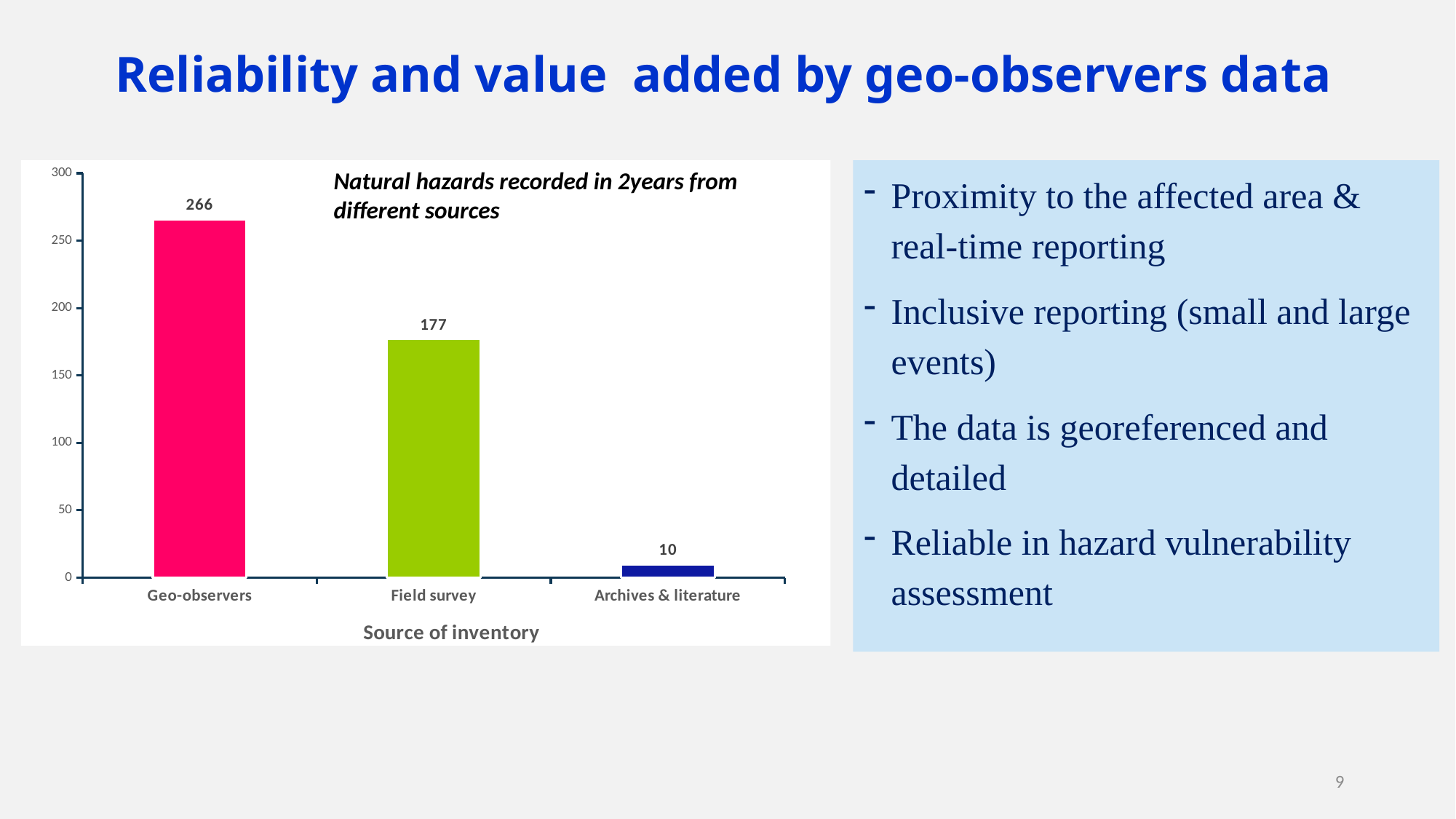
What is the difference between the values for Field survey and Archives & literature? 167 What is the value for Field survey? 177 What is the value for Archives & literature? 10 What kind of chart is shown on the slide? Bar chart What is the title of the chart? Natural hazards recorded in 2years from different sources Which source of inventory has the lowest number of recorded natural hazards? Archives & literature Which is larger, the value for Field survey or the value for Archives & literature? Field survey What is the difference between the values for Geo-observers and Field survey? 89 What is the value for Geo-observers? 266 How many sources of inventory are shown on the chart? 3 Which source of inventory has the highest number of recorded natural hazards? Geo-observers Is the value for Geo-observers greater or less than 250? greater